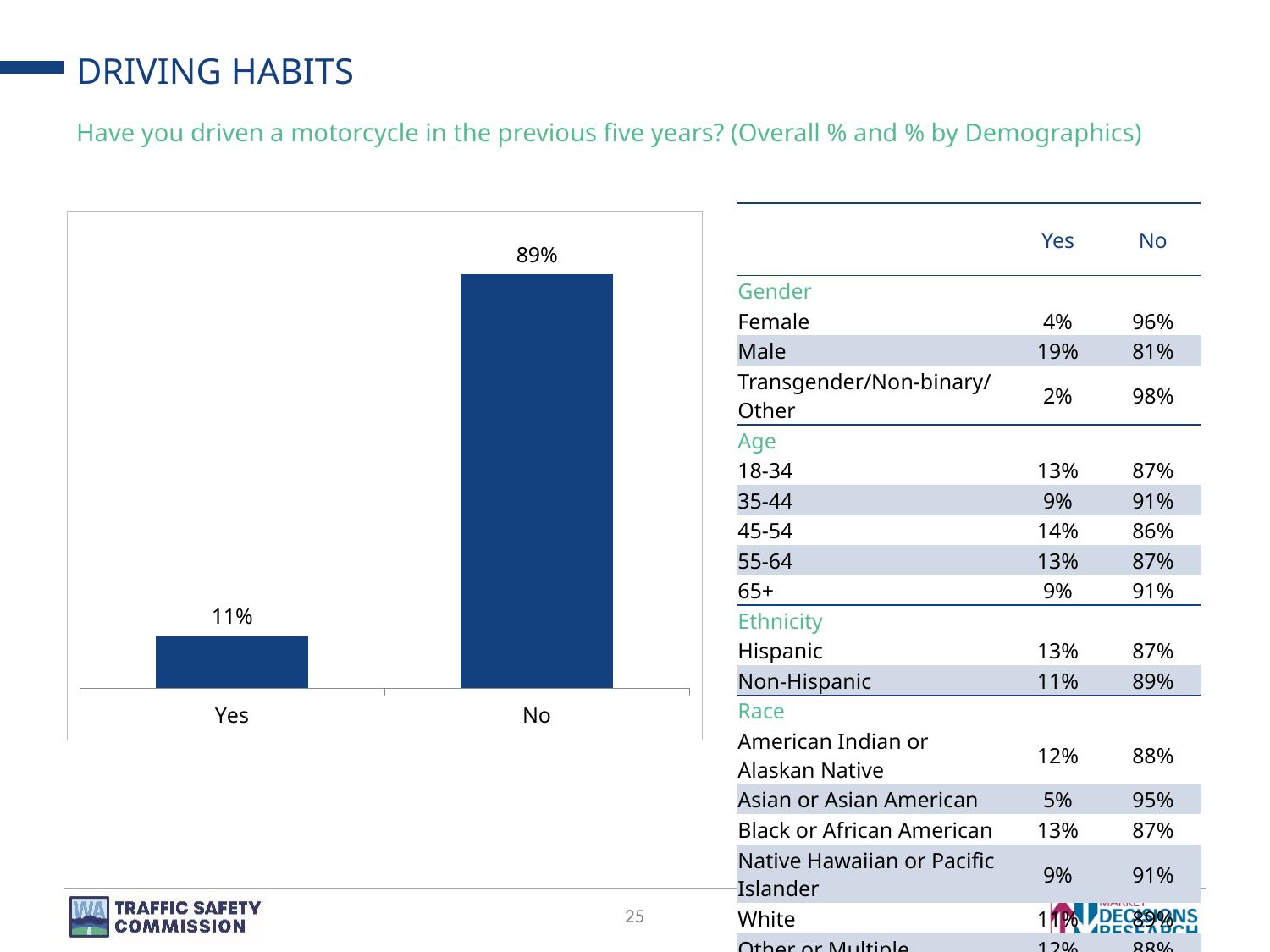
Which response category has the lowest value in the chart? Yes What percentage of respondents answered Yes to having driven a motorcycle in the previous five years? 11% What colour are the bars in the chart? Dark blue How many categories are shown on the x axis of the chart? 2 What is the total of the Yes and No percentages shown in the chart? 100% Which response category has the highest value in the chart? No What is the difference between the No and Yes percentages in the chart? 78% What question does the chart on the slide address? Have you driven a motorcycle in the previous five years? What kind of chart is shown on the slide? Bar chart What percentage of respondents answered No to having driven a motorcycle in the previous five years? 89% Which is larger in the chart, the value for Yes or the value for No? No